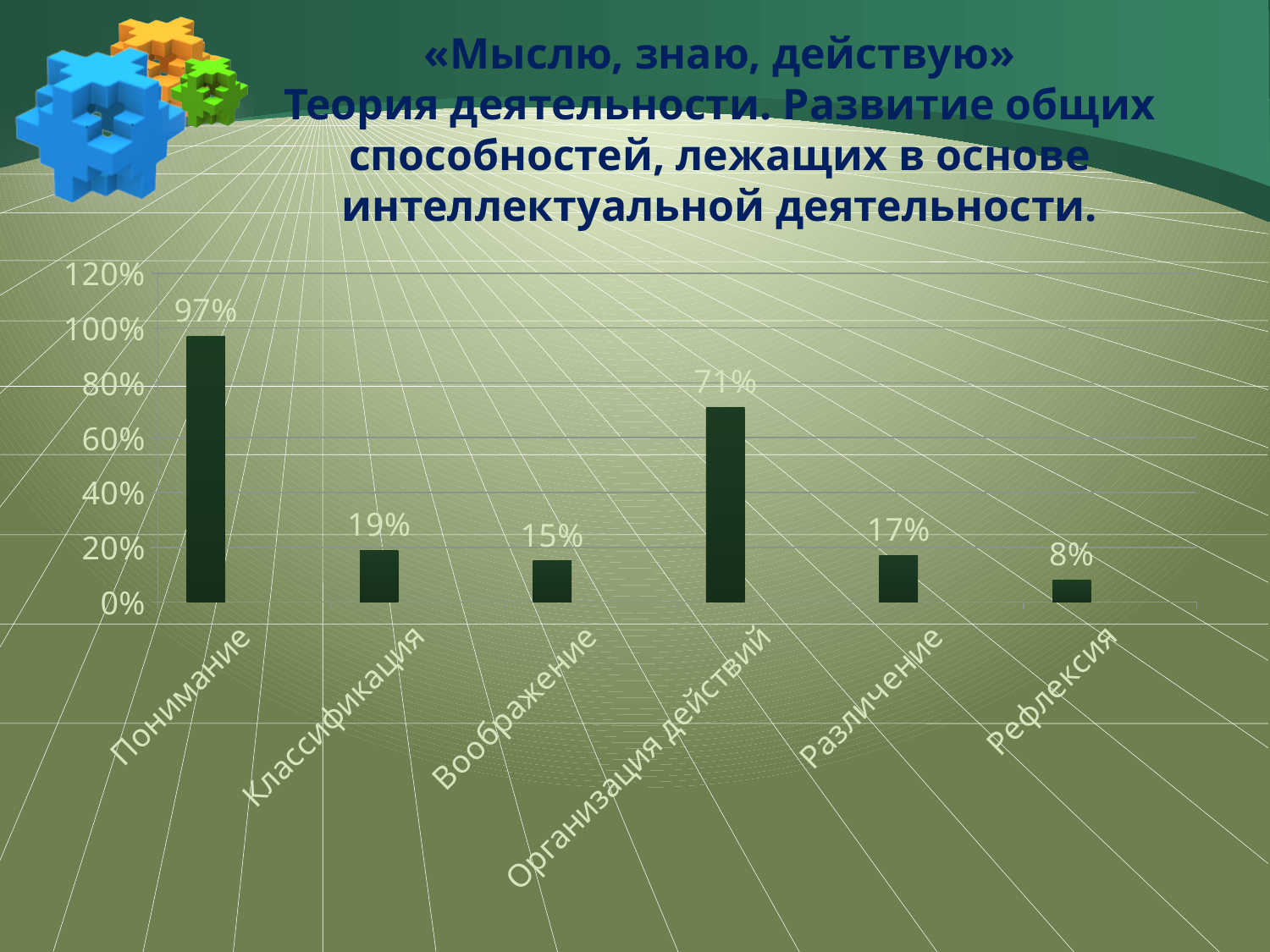
Which is larger, the value for Классификация or the value for Различение? Классификация What is the difference between the values for Классификация and Воображение? 4% Which category has the highest value? Понимание What is the difference between the values for Понимание and Организация действий? 26% What kind of chart is shown on the slide? bar chart Which category has the lowest value? Рефлексия What is the value for Воображение? 15% How many categories are shown on the chart? 6 What is the value for Рефлексия? 8% What is the value for Понимание? 97% What is the value for Организация действий? 71% Is the value for Организация действий greater or less than 60%? greater